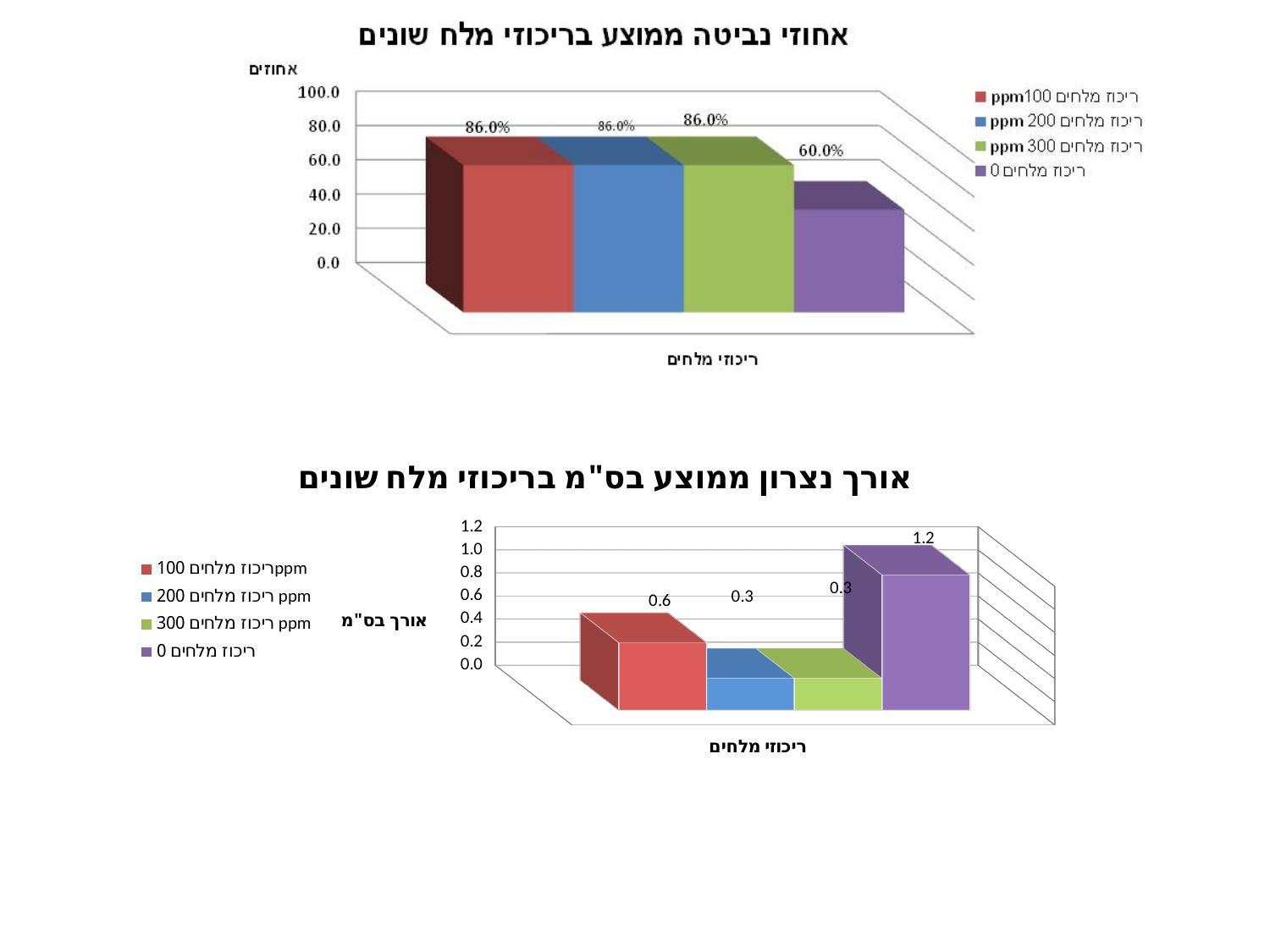
In the top chart, what is the value for the 100 ppm salt concentration series? 86.0% In the bottom chart, which series has the highest value? ריכוז מלחים 0 In the top chart, which series has the lowest value? ריכוז מלחים 0 In the top chart, what is the value for the 0 salt concentration series? 60.0% In the top chart, how many series does the legend list? 4 In the bottom chart, which is larger: the value for 100 ppm or the value for 200 ppm? 100 ppm In the bottom chart, what is the value for the 0 salt concentration series? 1.2 In the top chart, what is the difference between the 300 ppm value and the 0 salt concentration value? 26.0% What kind of chart is the top chart? Bar chart In the bottom chart, how many bars are plotted? 4 In the bottom chart, what is the difference between the 0 salt concentration value and the 200 ppm value? 0.9 In the bottom chart, what is the value for the 100 ppm salt concentration series? 0.6